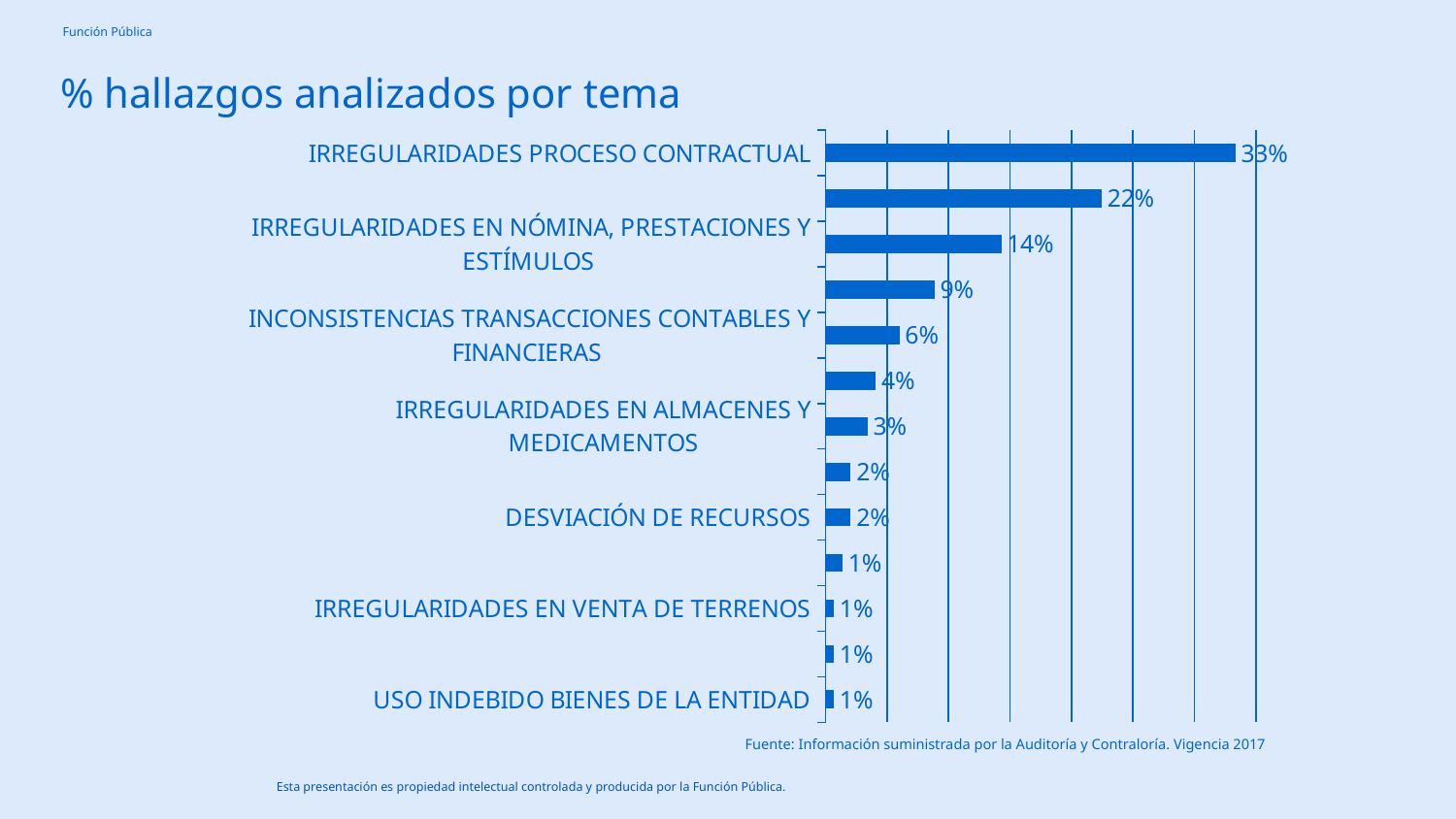
What is the title of the chart? % hallazgos analizados por tema What is the value for USO INDEBIDO BIENES DE LA ENTIDAD? 1% Which category has the highest value? IRREGULARIDADES PROCESO CONTRACTUAL What is the value for IRREGULARIDADES PROCESO CONTRACTUAL? 33% What is the value for INCONSISTENCIAS TRANSACCIONES CONTABLES Y FINANCIERAS? 6% What is the difference between the values for IRREGULARIDADES PROCESO CONTRACTUAL and IRREGULARIDADES EN NÓMINA, PRESTACIONES Y ESTÍMULOS? 19% How many bars are plotted in the chart? 13 What kind of chart is shown on the slide? Bar chart What is the value for IRREGULARIDADES EN ALMACENES Y MEDICAMENTOS? 3% What is the value for IRREGULARIDADES EN NÓMINA, PRESTACIONES Y ESTÍMULOS? 14% Which is larger, the value for INCONSISTENCIAS TRANSACCIONES CONTABLES Y FINANCIERAS or the value for IRREGULARIDADES EN ALMACENES Y MEDICAMENTOS? INCONSISTENCIAS TRANSACCIONES CONTABLES Y FINANCIERAS What is the value for DESVIACIÓN DE RECURSOS? 2%